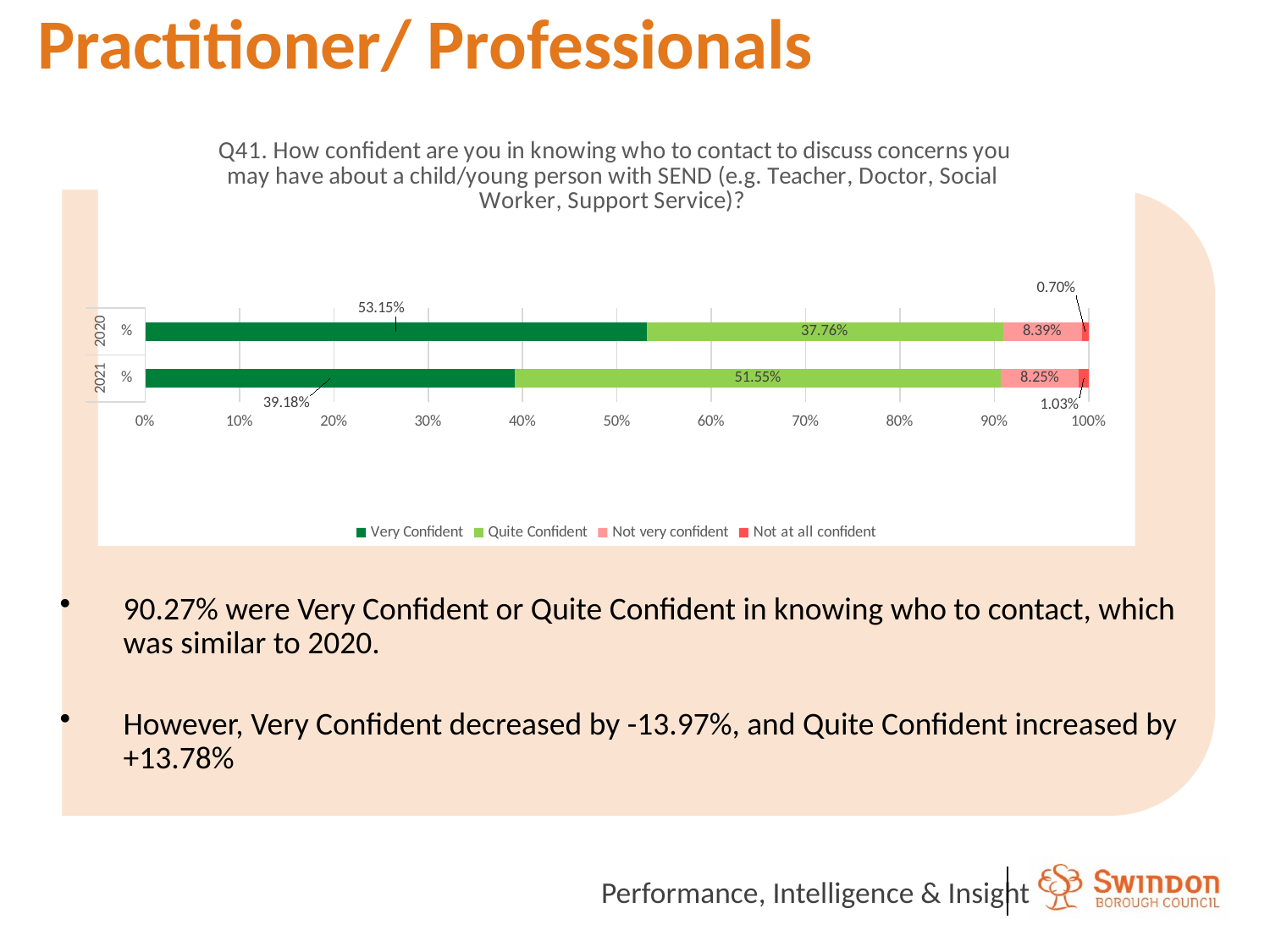
Which response category has the smallest value in 2020? Not at all confident What is the Very Confident value for 2020? 53.15% What is the difference between the Quite Confident values for 2021 and 2020? 13.79% How many bars (years) are plotted in the chart? 2 What is the Not very confident value for 2020? 8.39% Which series is shown in dark green in the legend? Very Confident What is the Not at all confident value for 2021? 1.03% How many series does the legend list? 4 What kind of chart is shown on the slide? Stacked bar chart What is the difference between the Very Confident values for 2020 and 2021? 13.97% Which year has the higher Very Confident value, 2020 or 2021? 2020 What is the Quite Confident value for 2021? 51.55%